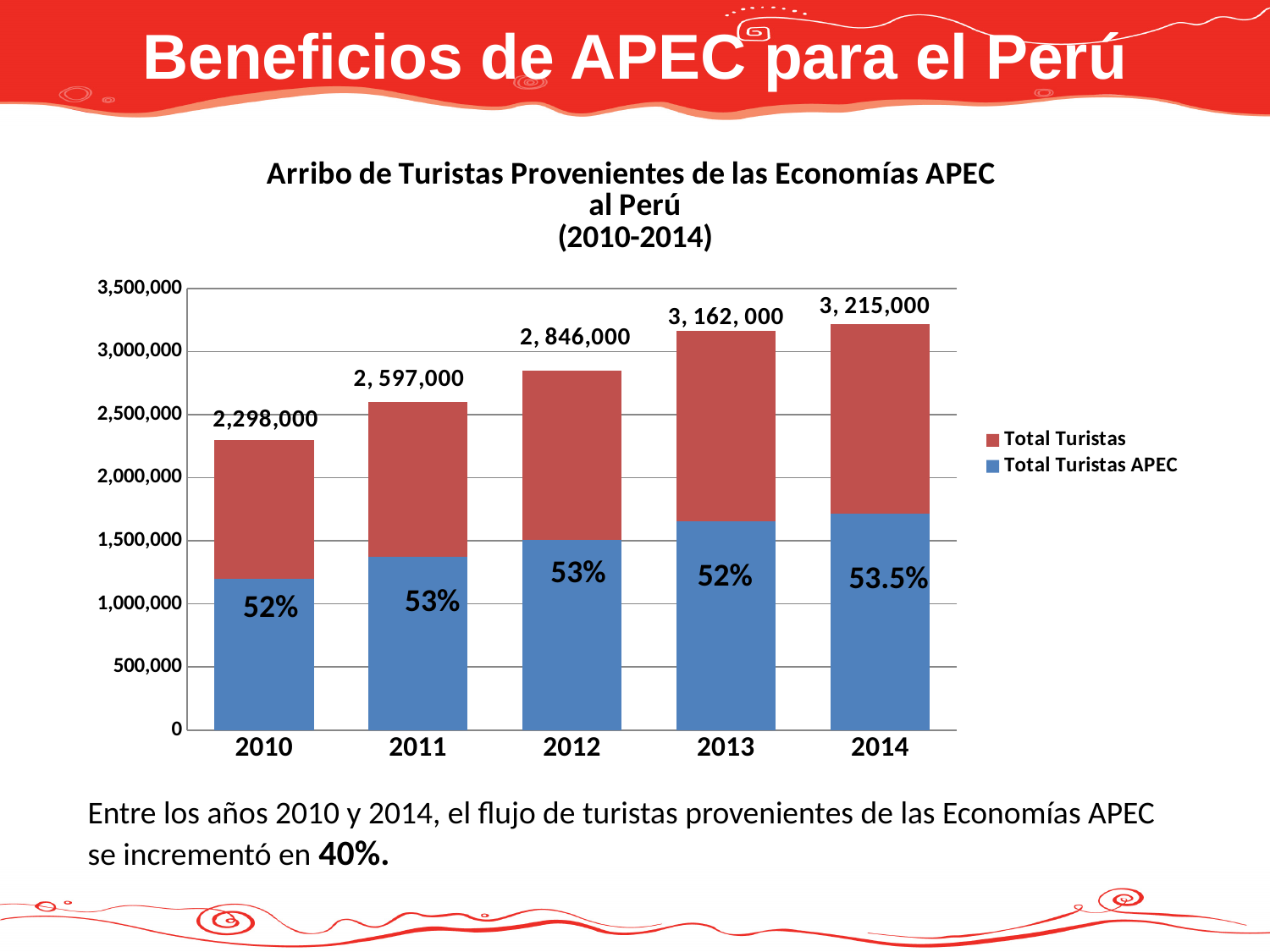
Which year has a larger total of tourists, 2012 or 2013? 2013 How many series does the legend list? 2 What percentage label is shown on the APEC segment for 2014? 53.5% Do the total tourist values rise or fall from 2010 to 2014? rise What is the difference between the total tourists in 2014 and in 2010? 917,000 What is the total number of tourists shown for 2014? 3,215,000 How many years are shown on the x axis of the chart? 5 Which year has the lowest total number of tourists? 2010 Which year has the highest total number of tourists? 2014 What is the total number of tourists shown for 2010? 2,298,000 What percentage label is shown on the APEC segment for 2011? 53% Is the value of the Total Turistas APEC segment for 2010 greater or less than 1,000,000? greater